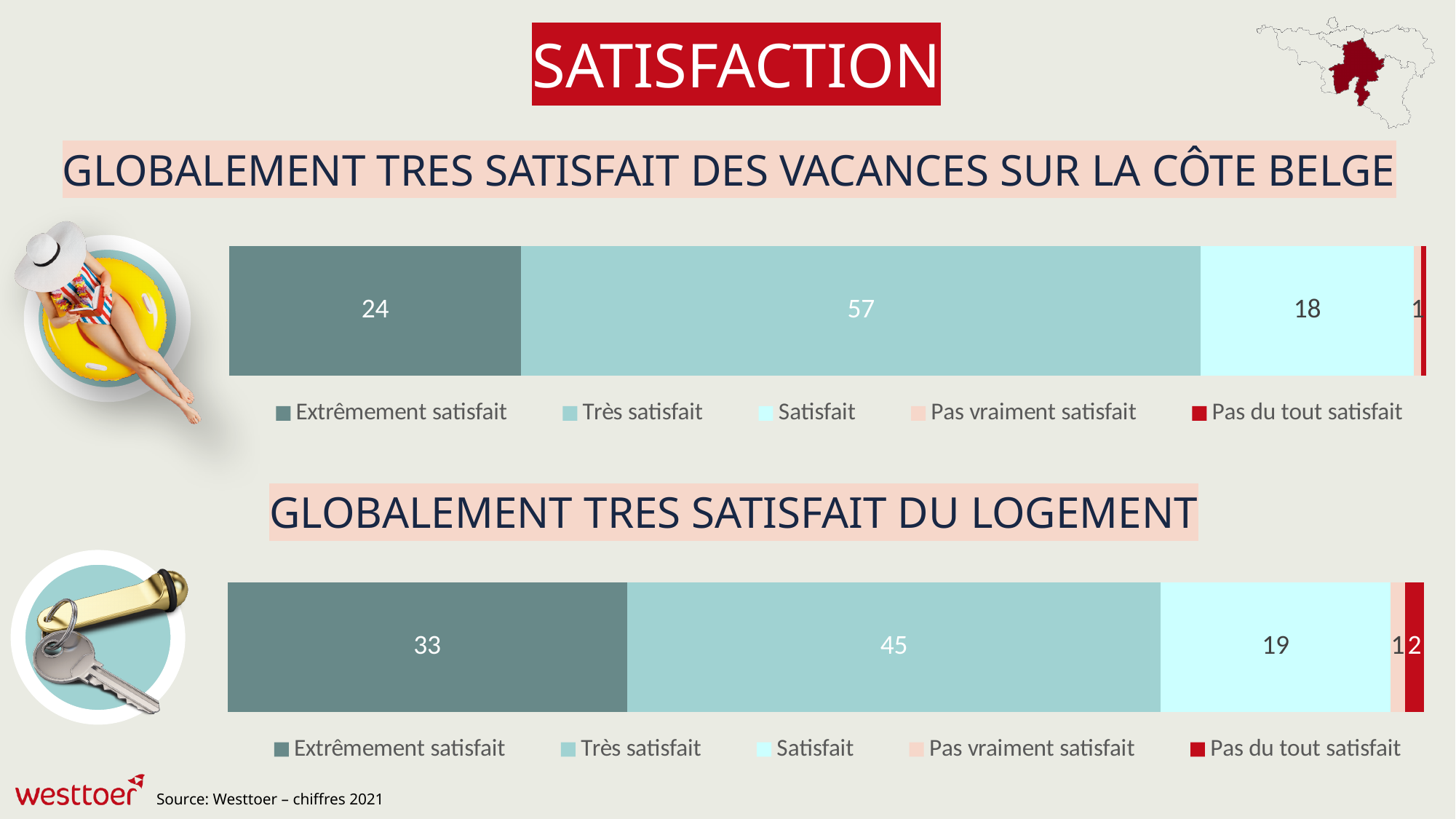
In the chart 'Globalement très satisfait du logement', which is larger: 'Extrêmement satisfait' or 'Satisfait'? Extrêmement satisfait In the chart 'Globalement très satisfait du logement', what is the value for 'Satisfait'? 19 In the chart 'Globalement très satisfait du logement', what is the value for 'Très satisfait'? 45 What kind of chart is 'Globalement très satisfait des vacances sur la côte belge'? Stacked bar chart In the chart 'Globalement très satisfait du logement', what is the value for 'Extrêmement satisfait'? 33 In the chart 'Globalement très satisfait du logement', what is the value for 'Pas du tout satisfait'? 2 In the chart 'Globalement très satisfait des vacances sur la côte belge', what is the value for 'Extrêmement satisfait'? 24 In the chart 'Globalement très satisfait des vacances sur la côte belge', what is the value for 'Très satisfait'? 57 In the chart 'Globalement très satisfait des vacances sur la côte belge', what is the value for 'Satisfait'? 18 In the chart 'Globalement très satisfait des vacances sur la côte belge', which category has the highest value? Très satisfait How many series does the legend of the chart 'Globalement très satisfait du logement' list? 5 In the chart 'Globalement très satisfait des vacances sur la côte belge', what is the difference between 'Très satisfait' and 'Extrêmement satisfait'? 33